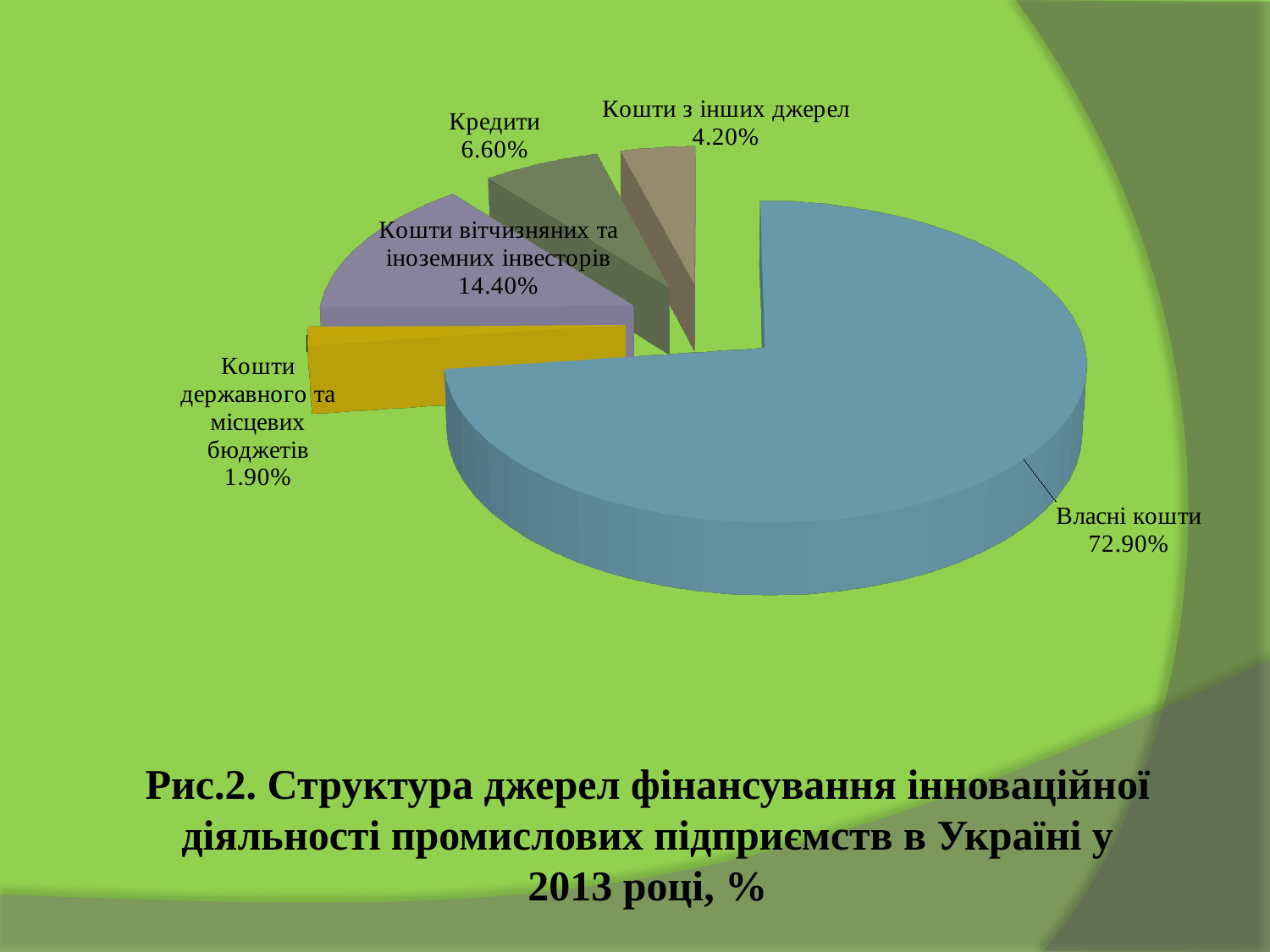
What share of the pie is labelled "Власні кошти"? 72.90% What year does the chart caption say the data refers to? 2013 Which is larger: the value for "Кошти вітчизняних та іноземних інвесторів" or the value for "Кредити"? Кошти вітчизняних та іноземних інвесторів What is the value shown for "Кошти державного та місцевих бюджетів"? 1.90% What is the value shown for "Кошти вітчизняних та іноземних інвесторів"? 14.40% How many slices does the pie chart have? 5 Which category has the smallest slice of the pie? Кошти державного та місцевих бюджетів What is the value shown for "Кошти з інших джерел"? 4.20% What is the value shown for "Кредити"? 6.60% Which category has the largest slice of the pie? Власні кошти What is the difference between the values for "Кредити" and "Кошти з інших джерел"? 2.40% What kind of chart is shown on the slide? pie chart